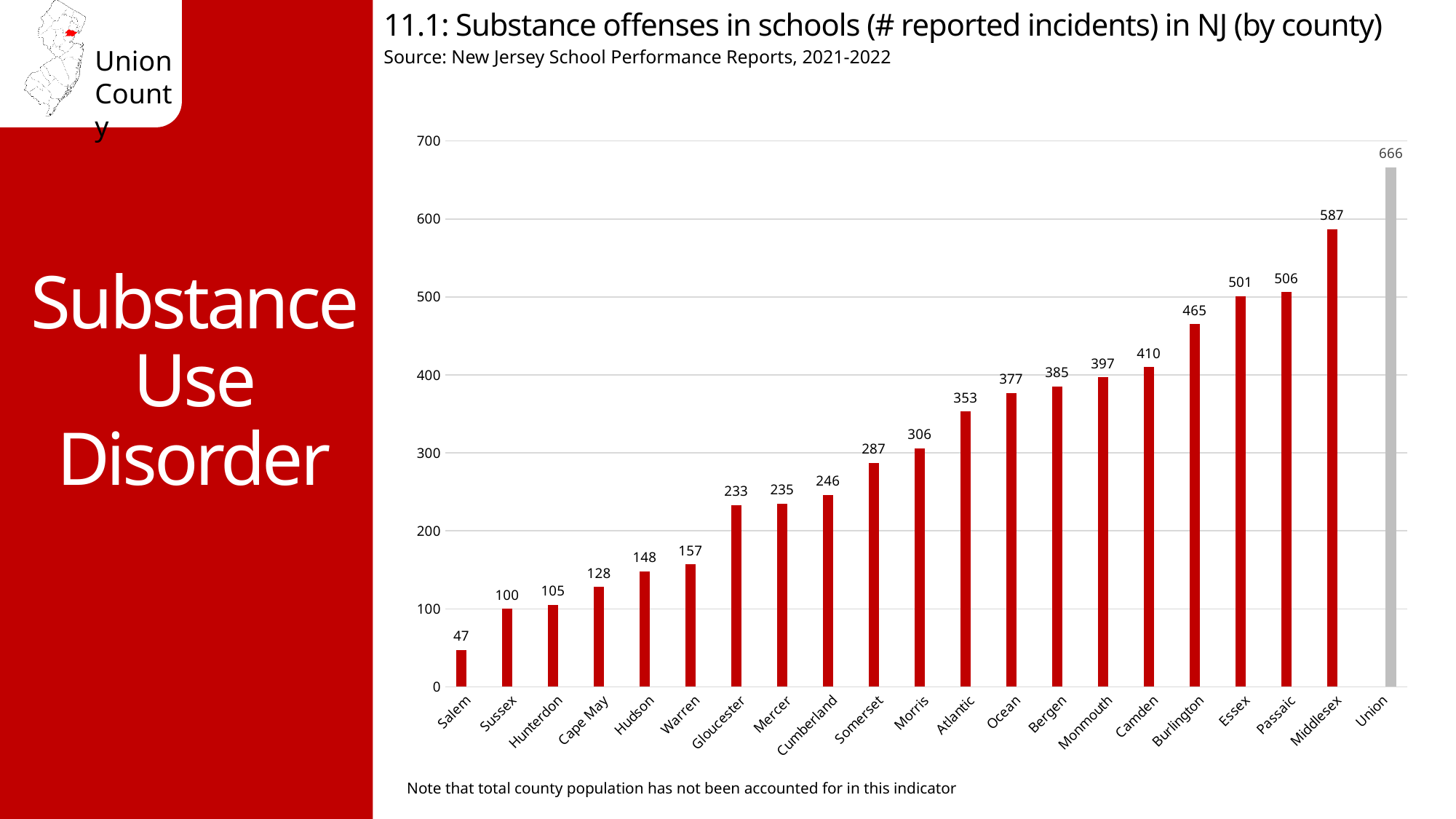
Which county has a larger value, Camden or Bergen? Camden What is the number of reported substance offense incidents in schools for Union county? 666 What is the difference between the values for Essex and Passaic? 5 How many counties are shown on the x axis of the chart? 21 What kind of chart is shown on the slide? Bar chart Is the value for Burlington greater or less than 400? greater Which county has the lowest number of reported incidents? Salem What is the value shown for Middlesex county? 587 What is the value shown for Salem county? 47 Do the values rise or fall moving from left to right along the x axis? Rise Which county has the highest number of reported incidents? Union What is the difference between the values for Union and Middlesex? 79